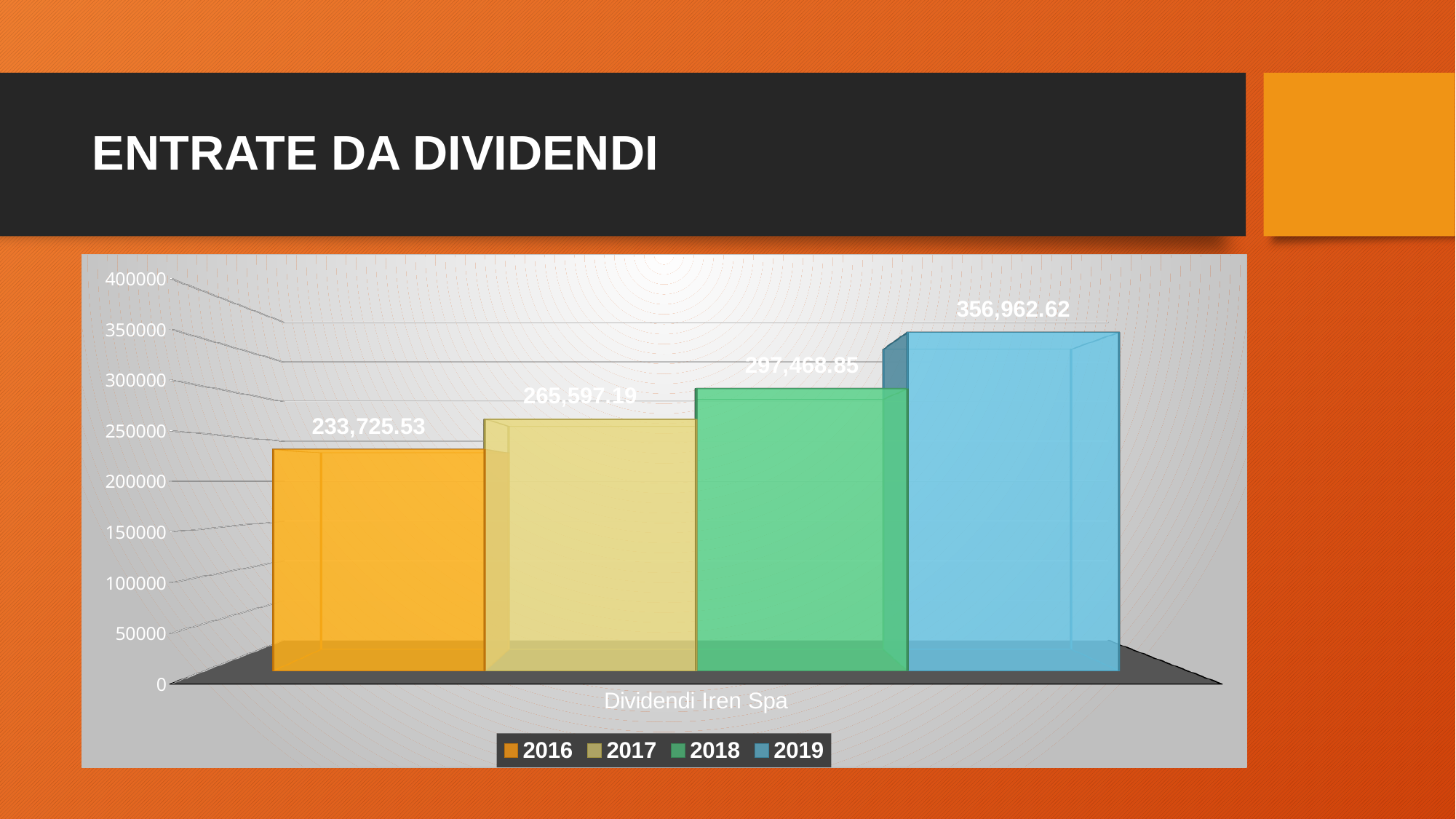
What is the difference between the 2019 value and the 2016 value? 123,237.09 What is the value for 2017 in the chart? 265,597.19 What kind of chart is shown on the slide? Bar chart How many series does the legend list? 4 Is the value for 2019 greater or less than 350000? greater What is the category label shown on the x axis of the chart? Dividendi Iren Spa Which year has the highest dividend income in the chart? 2019 What is the difference between the 2018 value and the 2017 value? 31,871.66 What is the value for 2019 in the chart? 356,962.62 What is the value for 2016 in the chart? 233,725.53 Which year has the lowest dividend income in the chart? 2016 Which is larger, the value for 2018 or the value for 2017? 2018